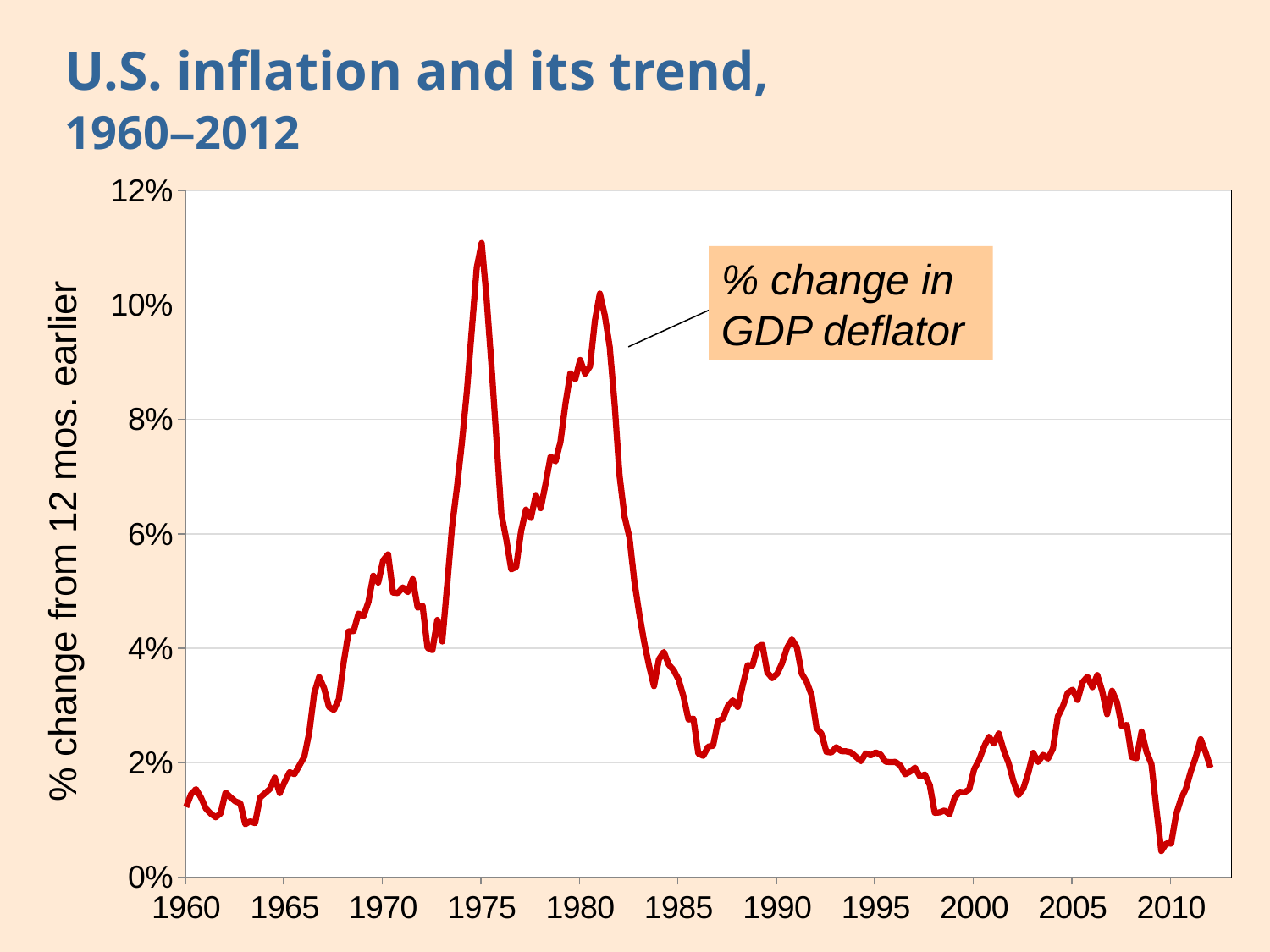
Does the line rise or fall between 1965 and 1970? rise What is the title of the chart? U.S. inflation and its trend, 1960–2012 Is the peak value of the line around 1975 greater or less than 10%? greater Is the peak value of the line around 1981 greater or less than 8%? greater Is the lowest value of the line around 2009–2010 greater or less than 2%? less Which is higher: the peak around 1975 or the peak around 1981? the peak around 1975 How many data series are plotted on the chart? 1 What kind of chart is shown on the slide? line chart Does the line rise or fall between 1981 and 1986? fall What does the annotation box say the plotted line represents? % change in GDP deflator Around which year does the line reach its highest value? 1975